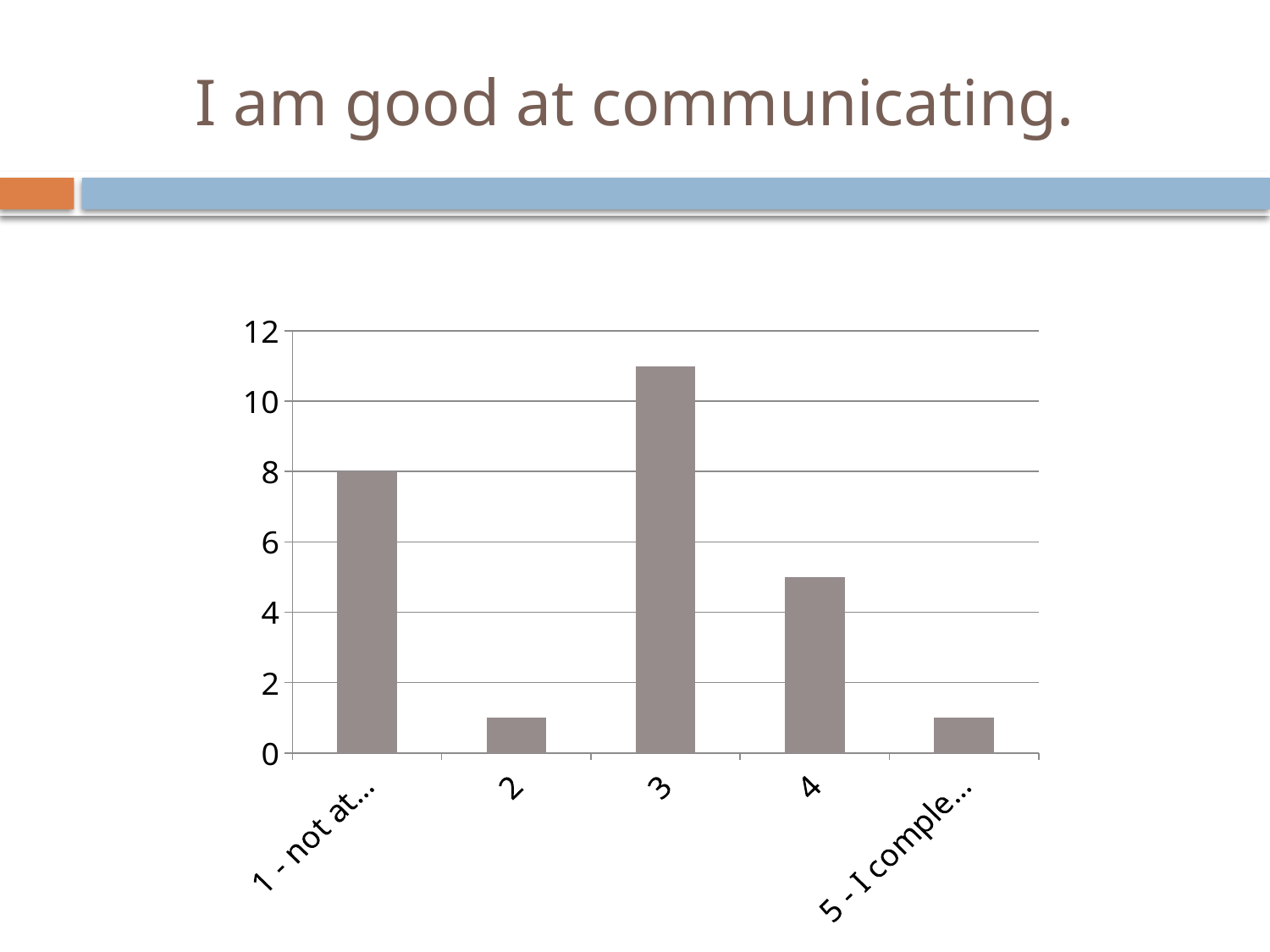
Which is larger, the value for "1 - not at..." or the value for category 2? 1 - not at... Is the value for category 2 greater or less than 2? less What is the title of the slide containing the chart? I am good at communicating. Is the value for "5 - I comple..." greater or less than 2? less How many categories are shown on the x axis? 5 Which is larger, the value for category 3 or the value for category 4? 3 Is the value for category 3 greater or less than 10? greater Which category has the highest bar? 3 What kind of chart is shown on the slide? bar chart What is the value for the category "1 - not at..."? 8